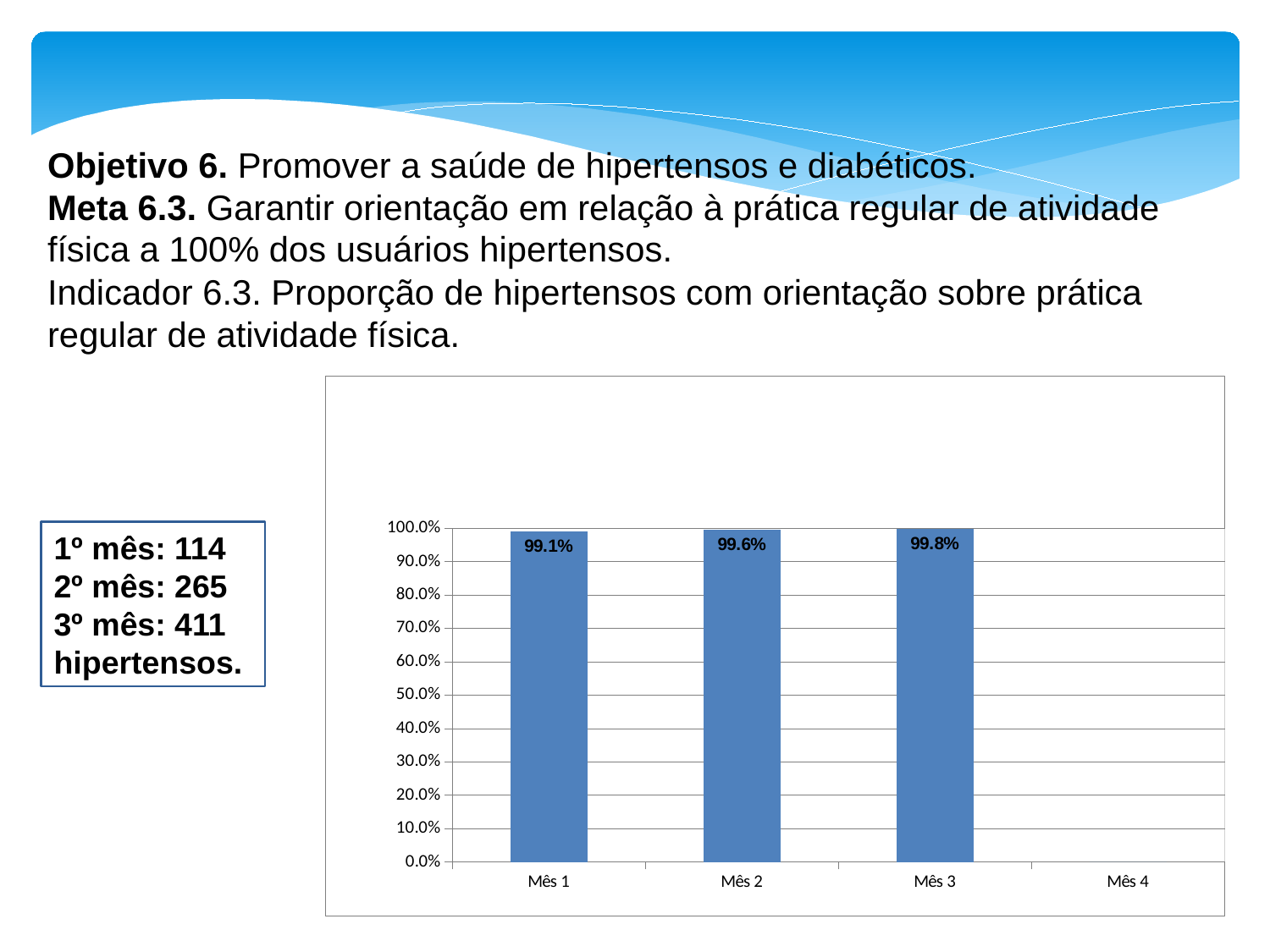
Which month with a plotted bar has the lowest value according to the data labels? Mês 1 What is the value shown for Mês 1? 99.1% What is the value shown for Mês 2? 99.6% What kind of chart is shown on the slide? bar chart Which month has the highest value according to the data labels? Mês 3 Which is larger according to the data labels, the value for Mês 2 or the value for Mês 3? Mês 3 How many bars are plotted in the chart? 3 What is the value shown for Mês 3? 99.8% What is the difference between the values for Mês 2 and Mês 1? 0.5% What is the difference between the values for Mês 3 and Mês 1? 0.7% Do the values rise or fall from Mês 1 to Mês 3? rise Is the value for Mês 1 greater or less than 90.0%? greater